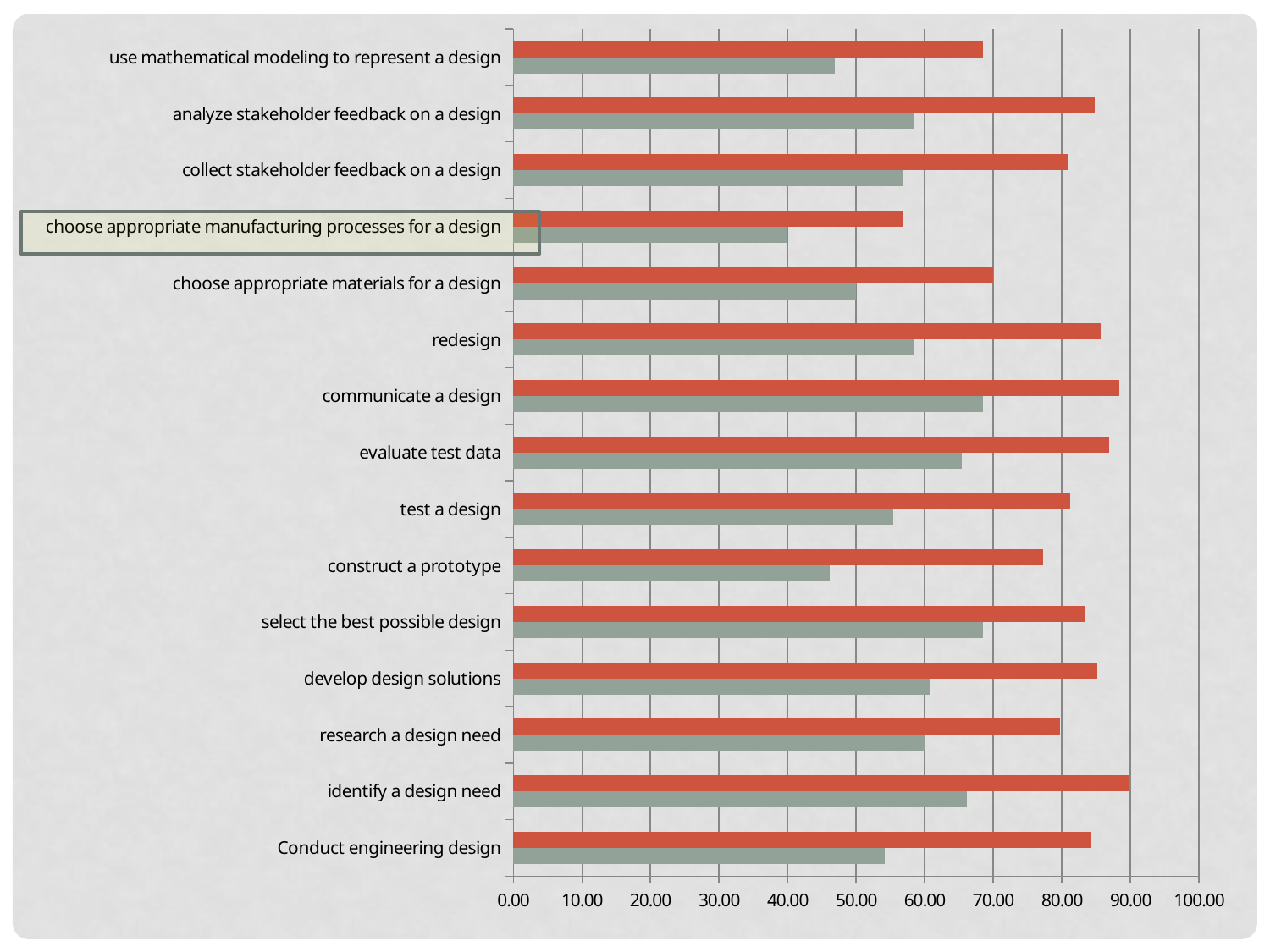
Is the red bar for 'construct a prototype' greater or less than 70? greater Which category has the shortest red bar? choose appropriate manufacturing processes for a design Which has the longer red bar: 'redesign' or 'construct a prototype'? redesign Which has the longer grey bar: 'evaluate test data' or 'test a design'? evaluate test data Is the grey bar for 'communicate a design' greater or less than 60? greater What kind of chart is shown on the slide? bar chart Is the red bar for 'choose appropriate manufacturing processes for a design' greater or less than 60? less How many bars are plotted for each category in the chart? 2 How many categories are listed on the vertical axis of the chart? 15 Which category label is highlighted with a box on the slide? choose appropriate manufacturing processes for a design Which category has the shortest grey bar? choose appropriate manufacturing processes for a design